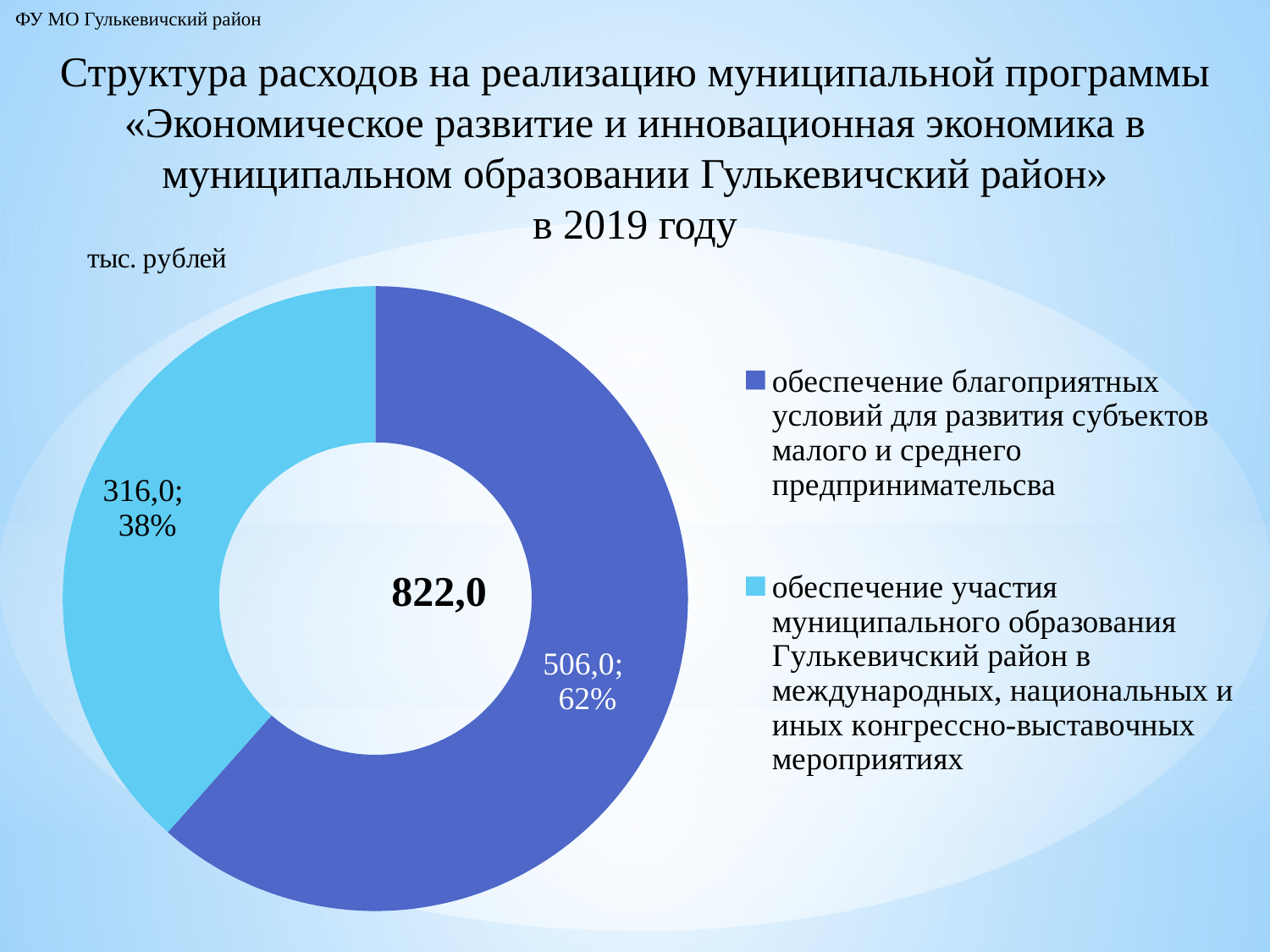
How many categories does the chart show? 2 Which is larger: the value for «обеспечение благоприятных условий...» or the value for «обеспечение участия муниципального образования...»? обеспечение благоприятных условий для развития субъектов малого и среднего предпринимательсва What is the total value shown in the centre of the chart? 822,0 What share of the chart does «обеспечение благоприятных условий для развития субъектов малого и среднего предпринимательсва» represent? 62% In what units are the values on the chart expressed? тыс. рублей What share of the chart does «обеспечение участия муниципального образования Гулькевичский район в международных, национальных и иных конгрессно-выставочных мероприятиях» represent? 38% Which category has the smallest value? обеспечение участия муниципального образования Гулькевичский район в международных, национальных и иных конгрессно-выставочных мероприятиях What kind of chart is shown on the slide? Doughnut (pie) chart What is the value for «обеспечение благоприятных условий для развития субъектов малого и среднего предпринимательсва»? 506,0 What is the value for «обеспечение участия муниципального образования Гулькевичский район в международных, национальных и иных конгрессно-выставочных мероприятиях»? 316,0 What is the difference between the two slices' values? 190,0 Which category has the largest value? обеспечение благоприятных условий для развития субъектов малого и среднего предпринимательсва